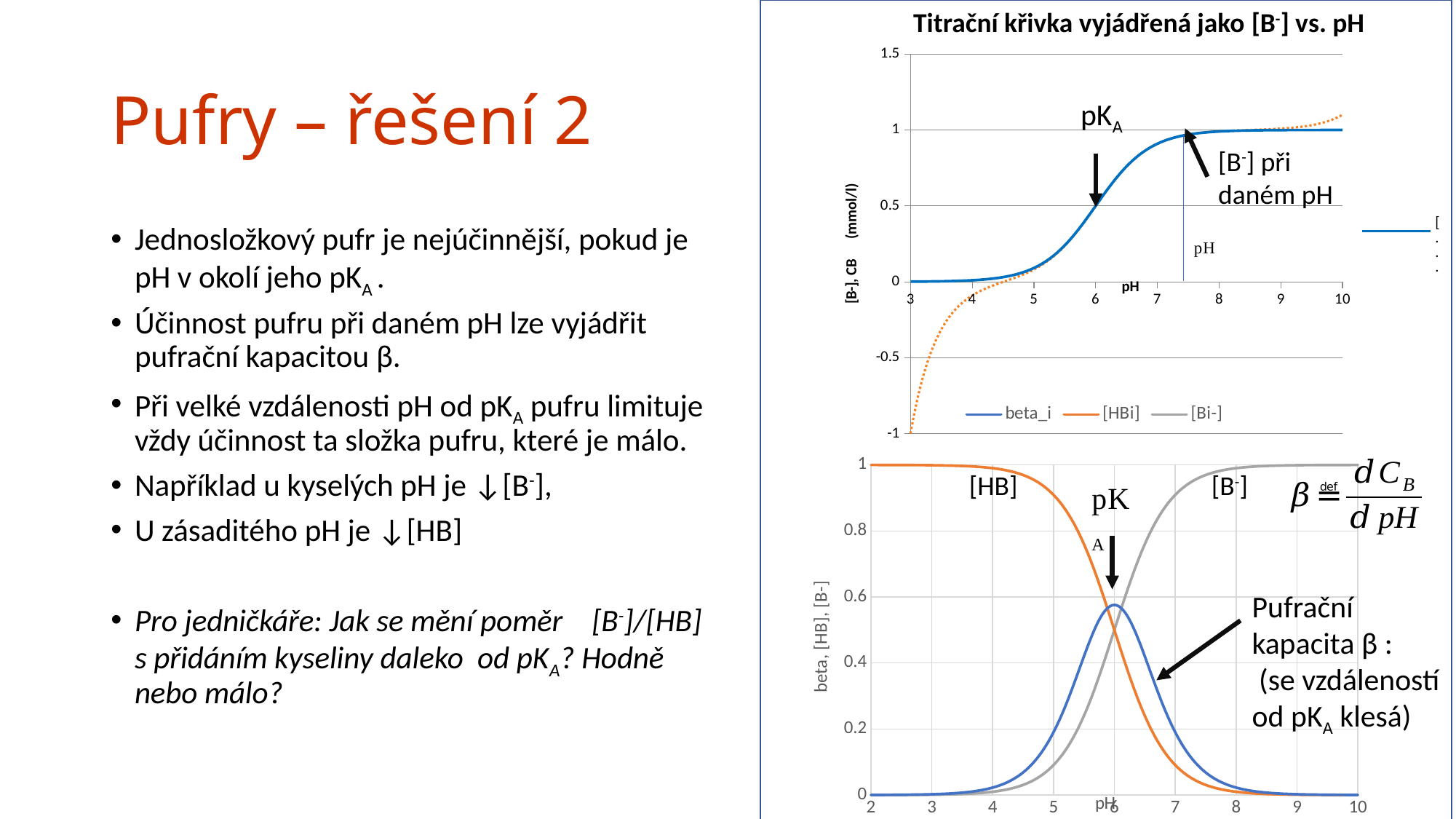
In the bottom chart, is the peak value of the blue beta_i curve greater or less than 0.4? greater In the bottom chart, at pH 3, which is larger: the [HB] curve or the [B-] curve? [HB] What is the title of the top chart? Titrační křivka vyjádřená jako [B-] vs. pH What kind of chart is the top chart titled 'Titrační křivka vyjádřená jako [B-] vs. pH'? line chart In the top chart, is the value of the solid blue curve at pH 9 greater or less than 0.5? greater How many series does the legend of the bottom chart list? 3 In the top chart, is the value of the solid blue curve at pH 4 greater or less than 0.5? less In the top chart, does the solid blue curve rise or fall as pH increases from 3 to 10? rise What kind of chart is the bottom chart on the slide? line chart In the top chart, how many tick labels are shown on the pH axis? 8 In the bottom chart, does the orange [HB] curve rise or fall as pH increases? fall In the bottom chart, at pH 9, which is larger: the [HB] curve or the [B-] curve? [B-]